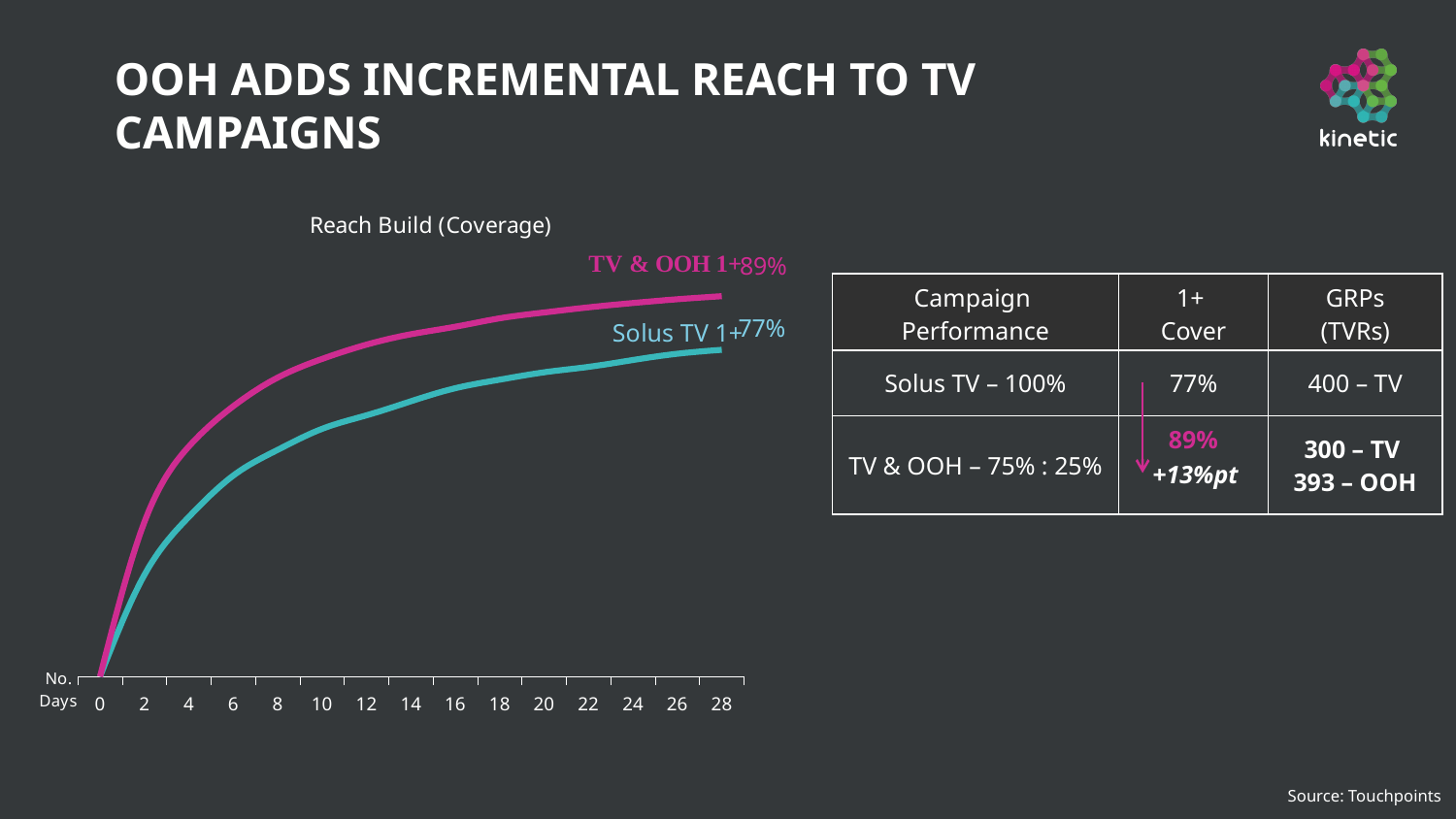
What kind of chart is shown under the heading "Reach Build (Coverage)"? Line chart What is the title of the chart on the slide? Reach Build (Coverage) Do the lines on the Reach Build (Coverage) chart rise or fall as the number of days increases? Rise Is the final value for Solus TV 1+ on the chart greater or less than the final value for TV & OOH 1+? less What final 1+ reach value is labelled for the Solus TV line on the chart? 77% What final 1+ reach value is labelled for the TV & OOH line on the chart? 89% What is the highest value shown on the x axis of the chart? 28 What is the label of the x axis on the chart? No. Days How many tick labels are shown on the x axis of the chart (from 0 to 28)? 15 Which line reaches the higher final coverage on the chart, TV & OOH 1+ or Solus TV 1+? TV & OOH 1+ Which series has the lowest final coverage value on the chart? Solus TV 1+ How many lines (series) are plotted on the Reach Build (Coverage) chart? 2